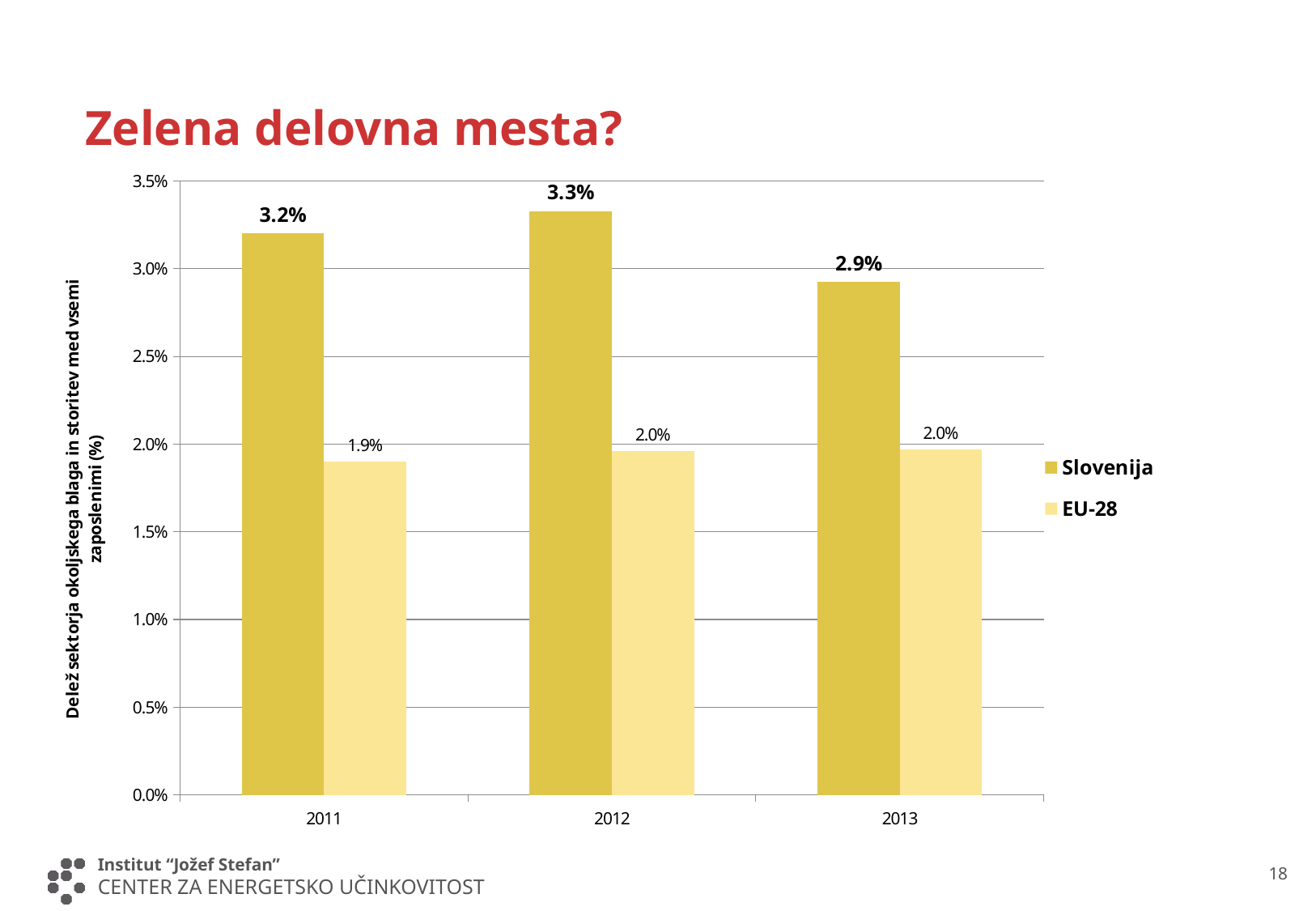
In which year is the Slovenija value highest? 2012 Which is larger in 2013, the Slovenija value or the EU-28 value? Slovenija How many years are shown on the x axis? 3 What is the value for Slovenija in 2012? 3.3% What kind of chart is shown on the slide? bar chart In which year is the Slovenija value lowest? 2013 What is the value for Slovenija in 2013? 2.9% What is the difference between the Slovenija and EU-28 values in 2011? 1.3% What is the title of the slide? Zelena delovna mesta? How many series does the legend list? 2 What is the value for EU-28 in 2011? 1.9% Is the value for Slovenija in 2013 greater or less than 3.0%? less